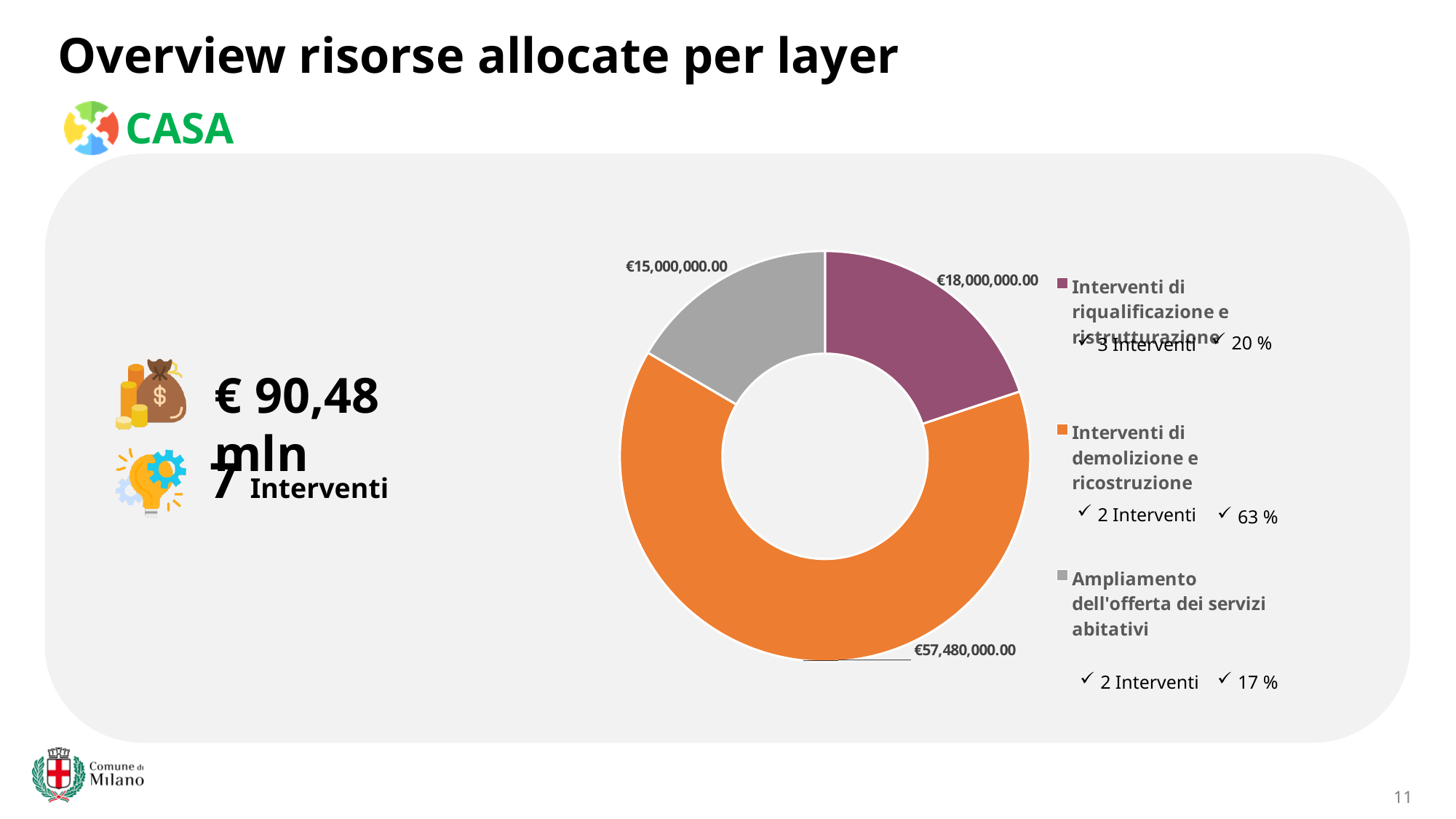
What is the value for Ampliamento dell'offerta dei servizi abitativi? €15,000,000.00 What is the value for Interventi di riqualificazione e ristrutturazione? €18,000,000.00 What share of the total does Interventi di demolizione e ricostruzione represent, as shown on the slide? 63 % What is the difference between the value for Interventi di demolizione e ricostruzione and the value for Interventi di riqualificazione e ristrutturazione? €39,480,000.00 What is the value for Interventi di demolizione e ricostruzione? €57,480,000.00 How many slices does the doughnut chart have? 3 What type of chart is shown on the slide? Doughnut chart What colour is the slice for Interventi di demolizione e ricostruzione? Orange What share of the total does Ampliamento dell'offerta dei servizi abitativi represent, as shown on the slide? 17 % Which category has the largest slice? Interventi di demolizione e ricostruzione Which is larger: the value for Interventi di riqualificazione e ristrutturazione or the value for Ampliamento dell'offerta dei servizi abitativi? Interventi di riqualificazione e ristrutturazione Which category has the smallest slice? Ampliamento dell'offerta dei servizi abitativi